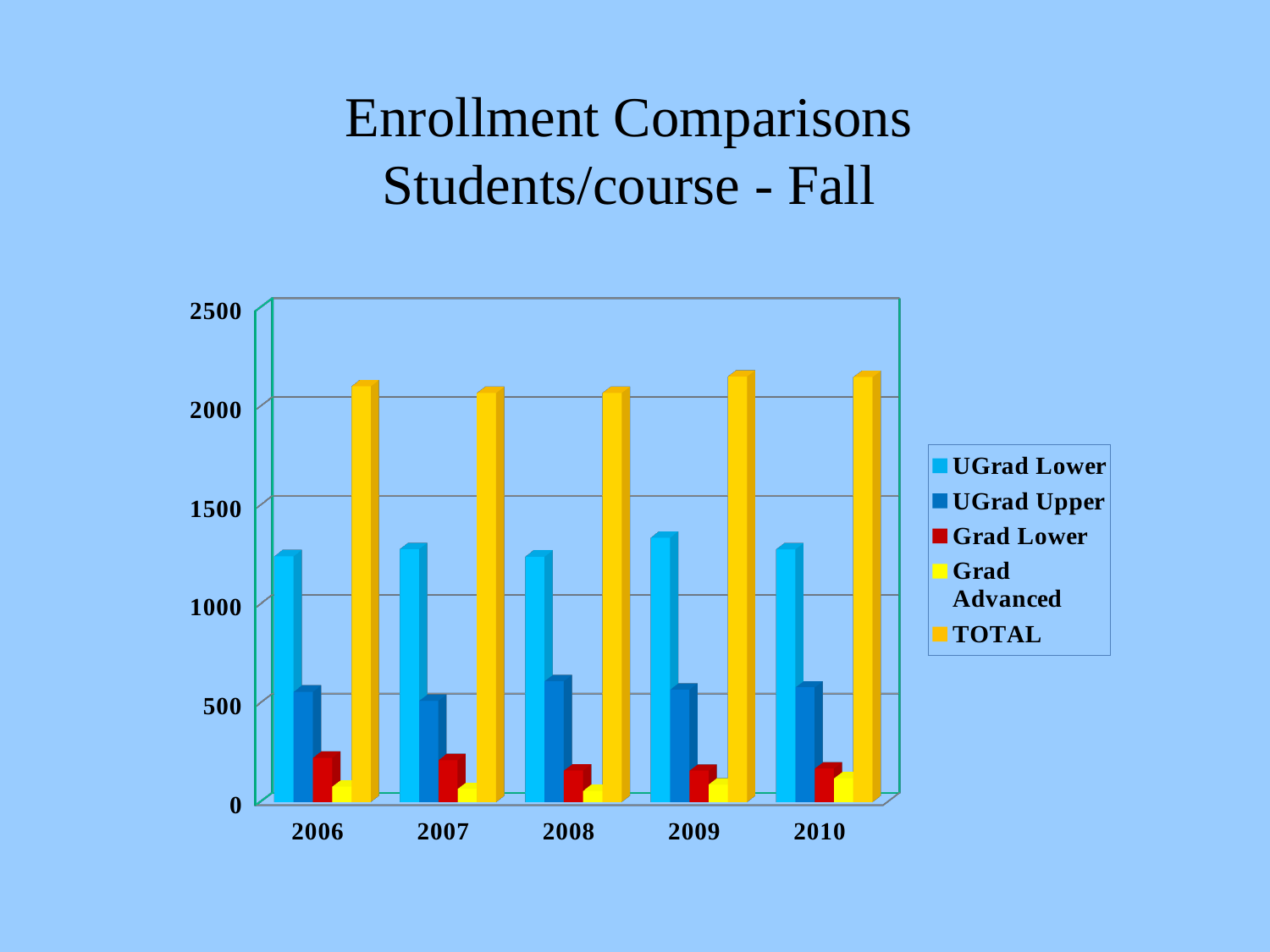
What kind of chart is shown on the slide? bar chart How many years are shown on the x axis? 5 Is the UGrad Lower value for 2007 greater or less than 1000? greater Is the TOTAL value for 2009 greater or less than 2000? greater Which series is shown in red? Grad Lower What is the title of the chart? Enrollment Comparisons Students/course - Fall Which series has the shortest bar in 2009? Grad Advanced How many series does the legend list? 5 In 2008, which is larger: Grad Lower or Grad Advanced? Grad Lower In 2010, which is larger: UGrad Lower or UGrad Upper? UGrad Lower Is the Grad Lower value for 2006 greater or less than 500? less Which series has the tallest bar in 2006? TOTAL